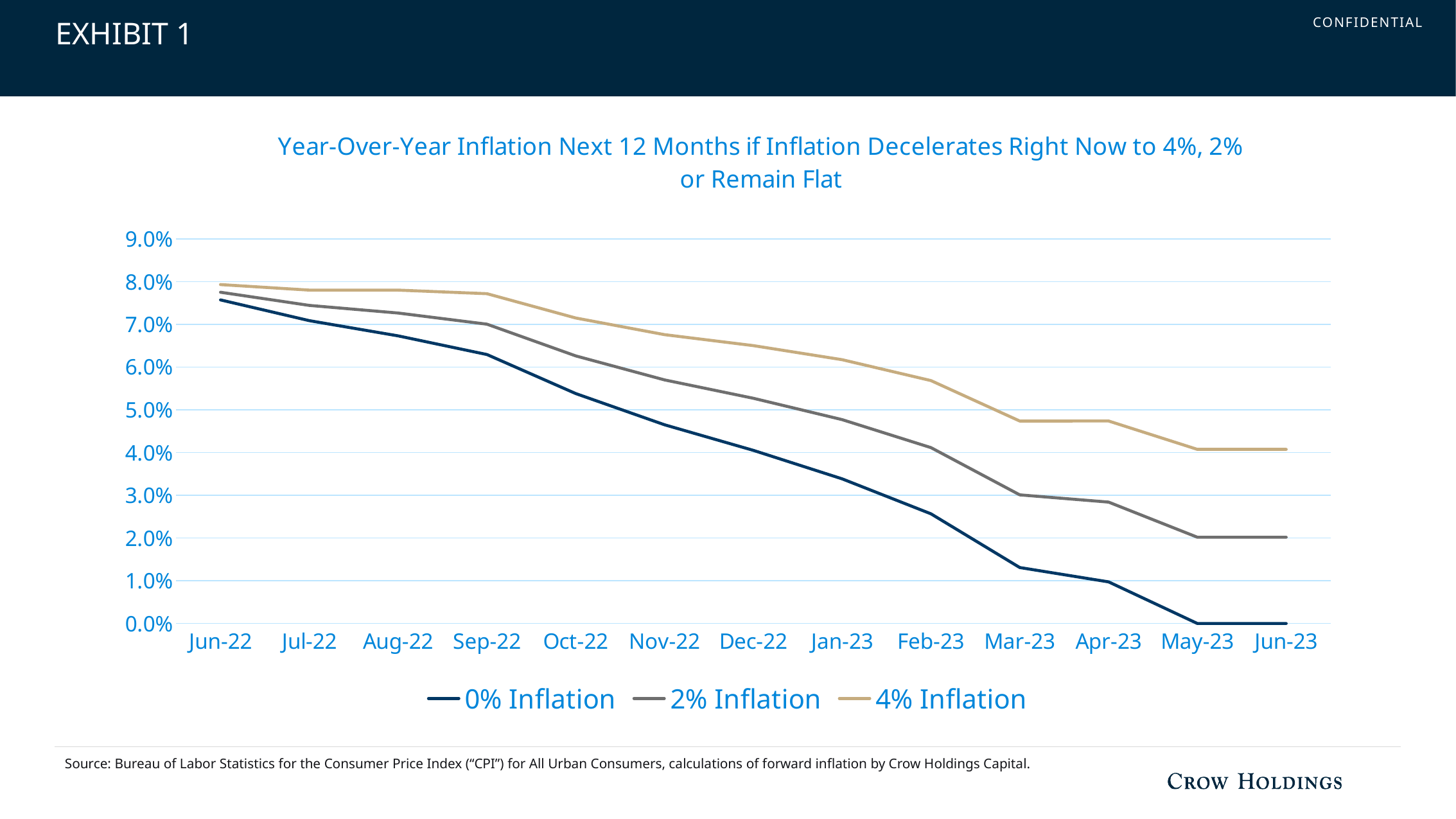
What is the value of the 0% Inflation series in Jun-23? 0.0% How many months are shown along the x axis? 13 What is the title of the chart? Year-Over-Year Inflation Next 12 Months if Inflation Decelerates Right Now to 4%, 2% or Remain Flat Which series has the lowest value in Mar-23? 0% Inflation What kind of chart is shown on the slide? line chart How many series does the legend list? 3 Which series has the highest value in Jun-23? 4% Inflation Is the value of the 4% Inflation series in Jun-22 greater or less than 7.0%? greater Do the values of the 0% Inflation series rise or fall from Jun-22 to Jun-23? fall Is the value of the 0% Inflation series in Oct-22 greater or less than 6.0%? less In Feb-23, which is larger: the 4% Inflation value or the 0% Inflation value? 4% Inflation